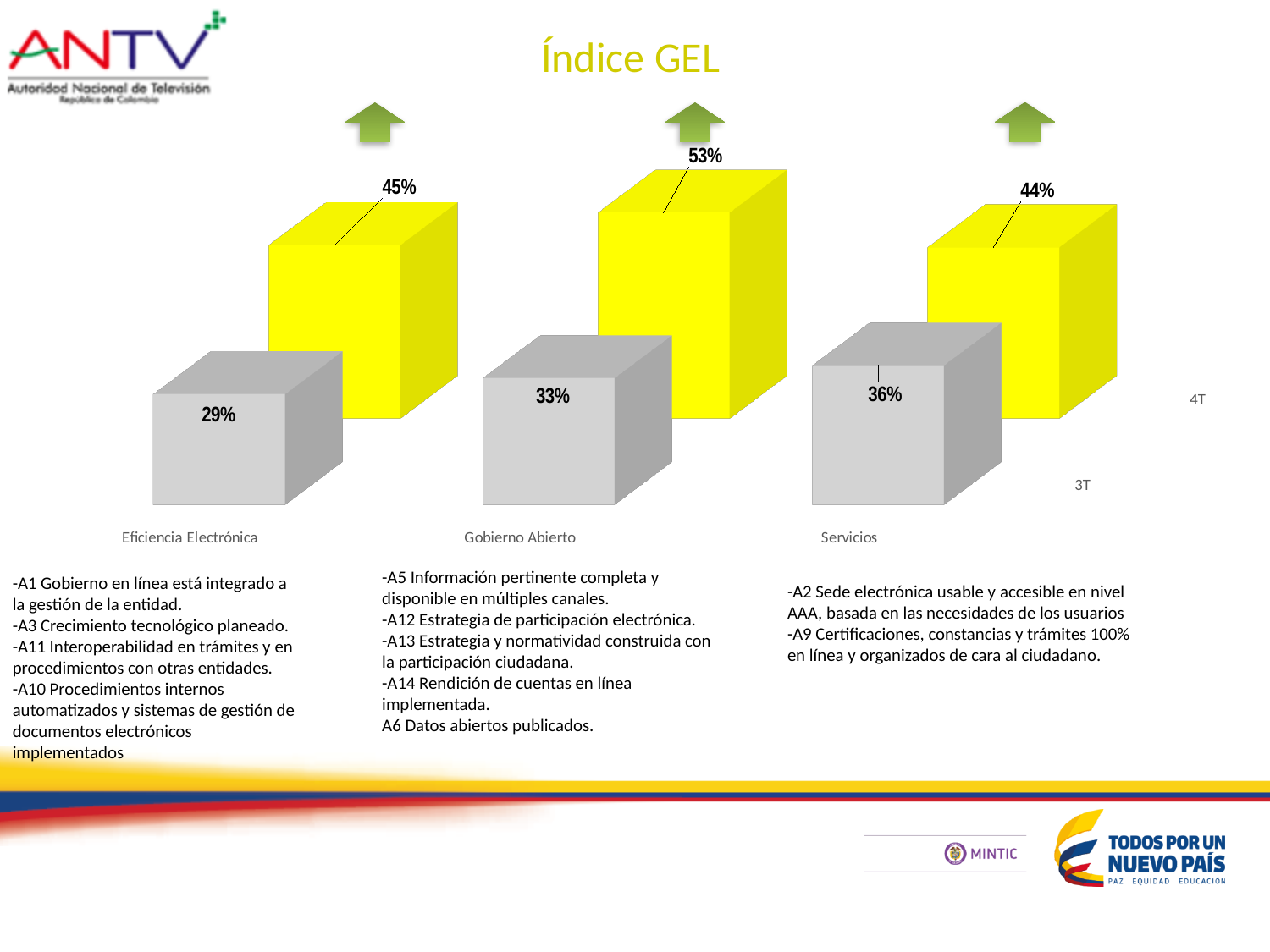
How many series does the chart show? 2 What is the 3T value for Servicios? 36% What is the difference between the 4T and 3T values for Gobierno Abierto? 20% Which is larger for Servicios, the 3T value or the 4T value? 4T What is the title of the chart? Índice GEL What is the 4T value for Eficiencia Electrónica? 45% Which category has the highest 4T value? Gobierno Abierto Which category has the lowest 3T value? Eficiencia Electrónica How many categories are shown on the x axis of the chart? 3 What kind of chart is shown on the slide? bar chart What is the 3T value for Eficiencia Electrónica? 29% What is the 4T value for Gobierno Abierto? 53%